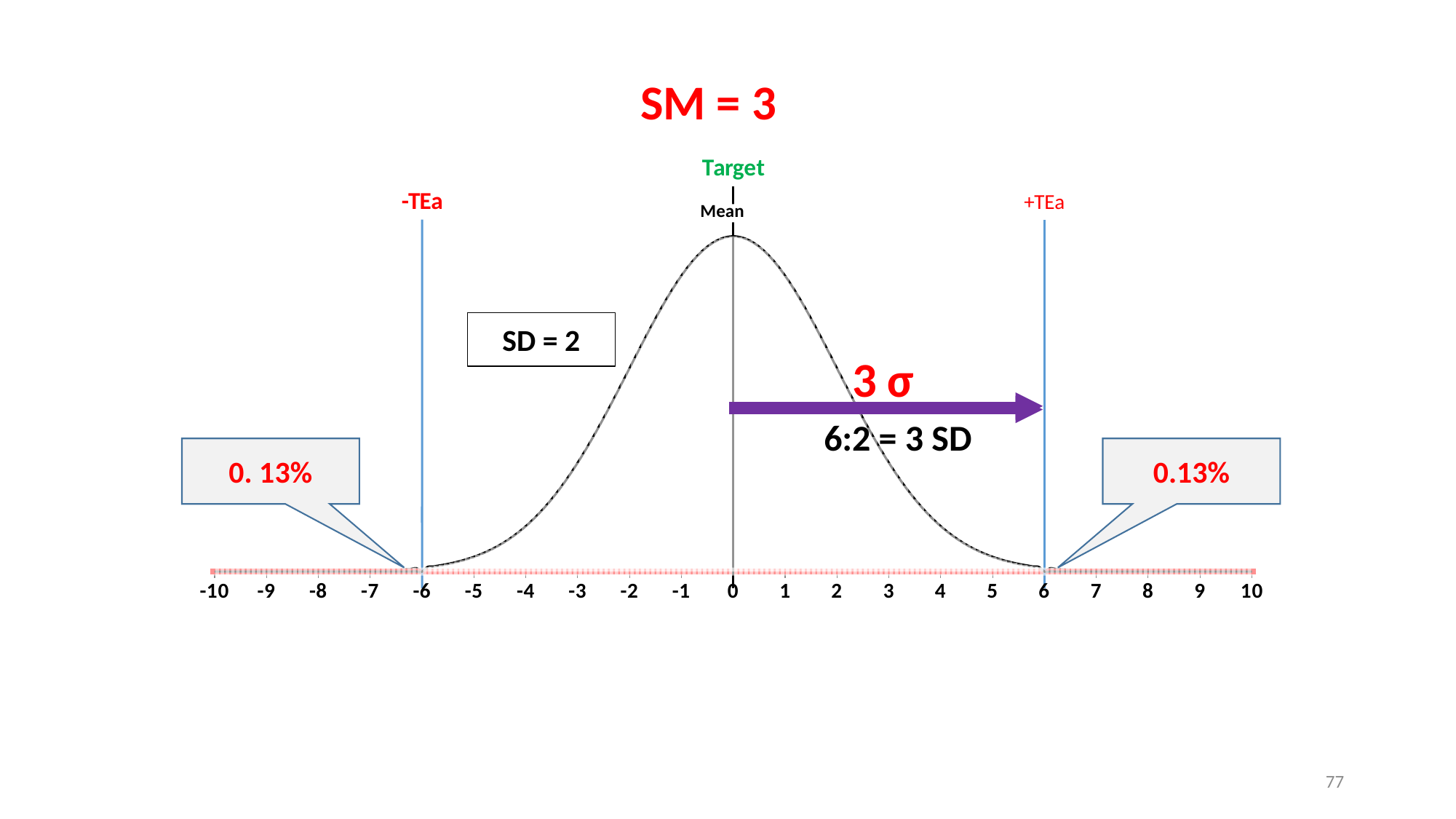
At what x-axis value is the -TEa line located? -6 What is the highest value labelled on the x axis? 10 How many tick labels are there on the x axis? 21 What value of SD is shown in the box on the chart? SD = 2 What value of SM is given in the chart title? SM = 3 What percentage is shown in the callout at the right tail of the curve? 0.13% What label is written above the purple arrow? 3 σ What is the lowest value labelled on the x axis? -10 At what x-axis value is the +TEa line located? 6 Does the curve rise or fall as x goes from 0 to 6? fall What kind of chart is shown on the slide? line chart (bell curve) At what x-axis value is the Mean line located? 0